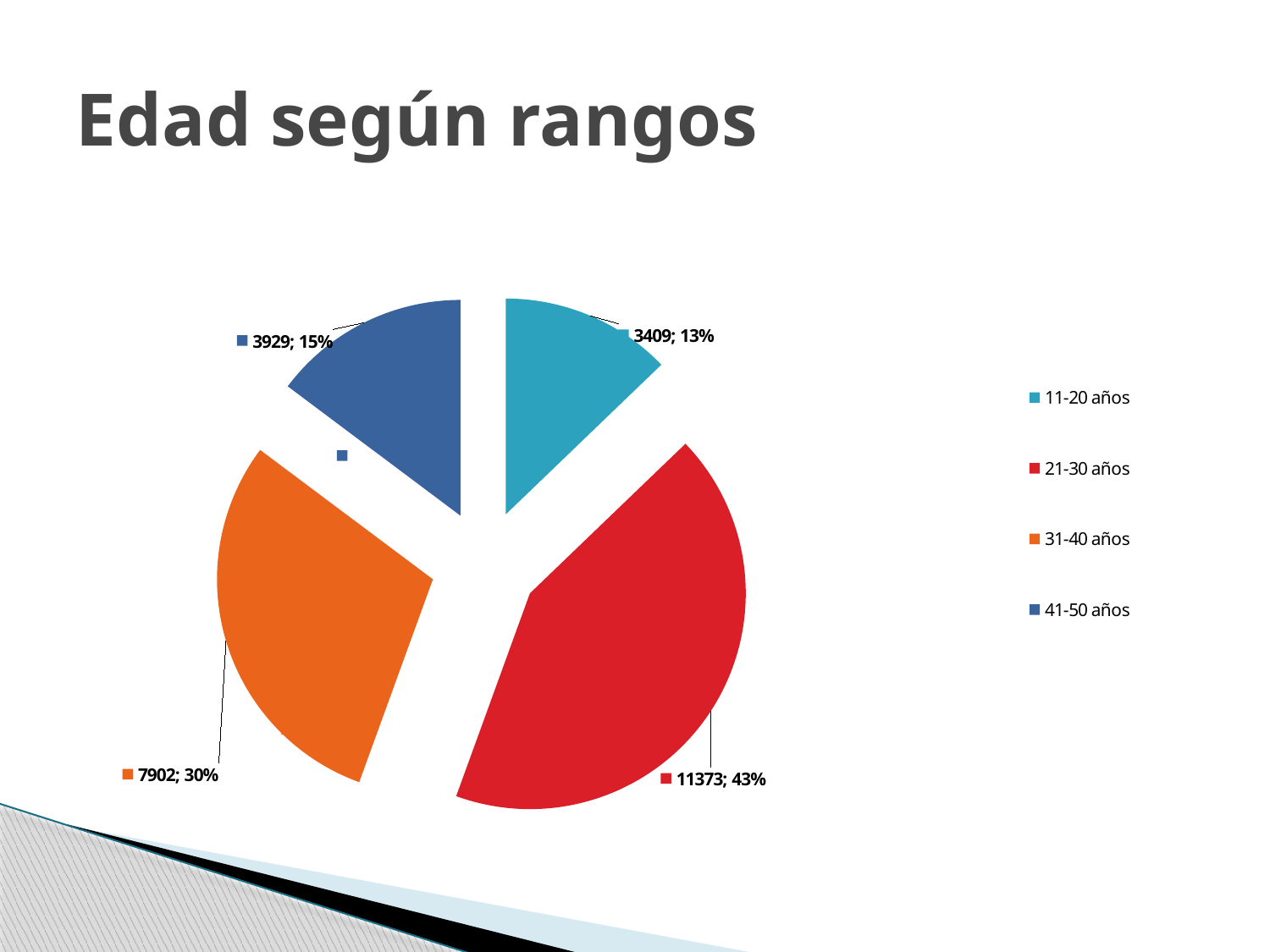
What is the value for the 11-20 años slice? 3409 What share of the pie does the 31-40 años slice represent? 30% What kind of chart is shown on the slide? pie chart Which is larger, the value for 41-50 años or the value for 11-20 años? 41-50 años Which age range has the largest slice? 21-30 años What share of the pie does the 41-50 años slice represent? 15% Which age range has the smallest slice? 11-20 años What is the value for the 31-40 años slice? 7902 What is the value for the 21-30 años slice? 11373 How many age ranges does the legend list? 4 What is the value for the 41-50 años slice? 3929 What is the difference between the values for 21-30 años and 31-40 años? 3471